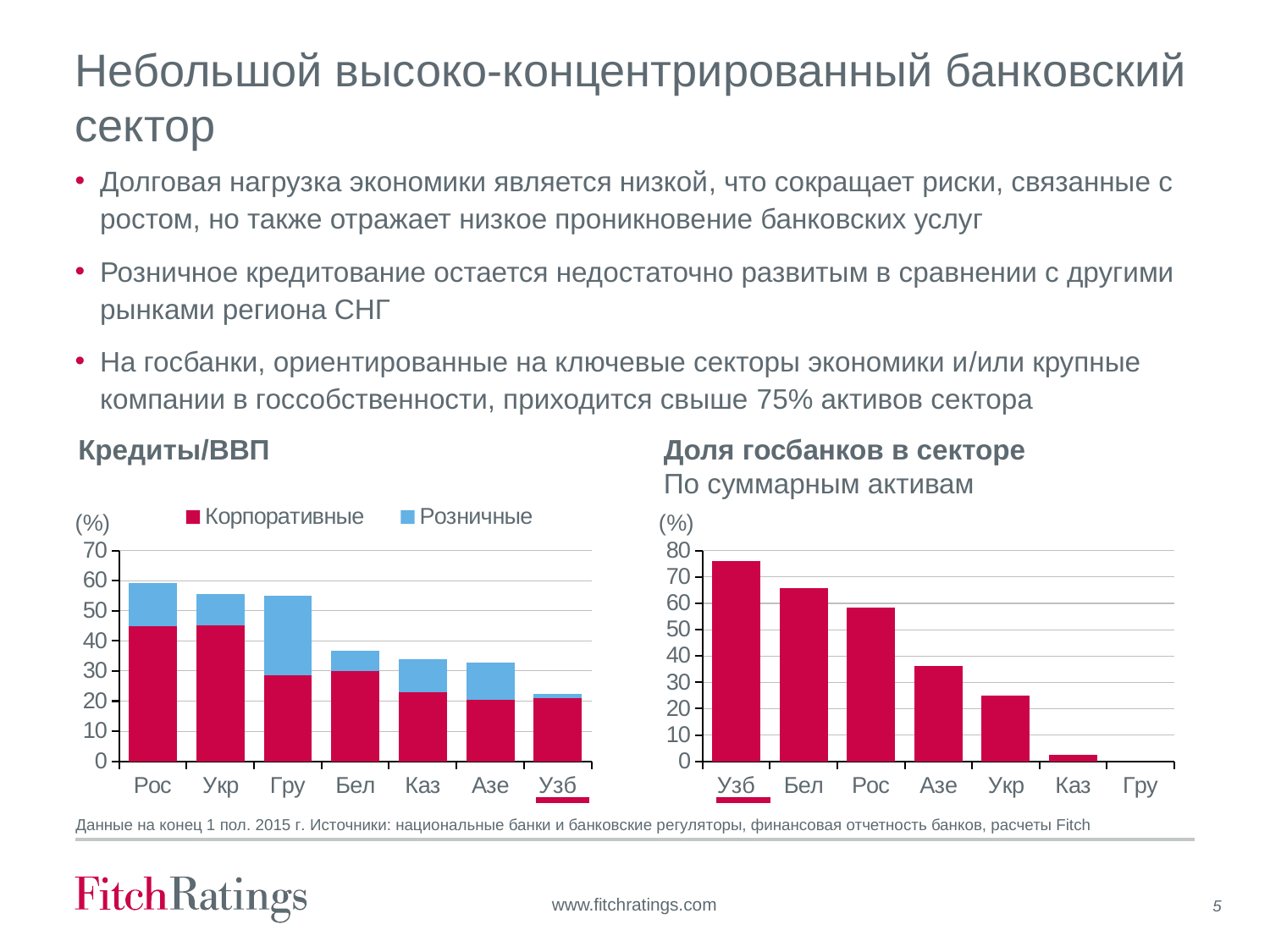
On the chart titled "Кредиты/ВВП", which country has the tallest stacked bar? Рос On the chart titled "Доля госбанков в секторе", which country has the highest value? Узб On the chart titled "Доля госбанков в секторе", is the value for Узб greater or less than 70? greater On the chart titled "Кредиты/ВВП", how many series does the legend list? 2 On the chart titled "Кредиты/ВВП", what are the two series named in the legend? Корпоративные and Розничные On the chart titled "Кредиты/ВВП", is the total stacked value for Узб greater or less than 30? less On the chart titled "Доля госбанков в секторе", how many countries are plotted? 7 On the chart titled "Доля госбанков в секторе", which country has the lowest value? Гру On the chart titled "Доля госбанков в секторе", do the values rise or fall from left to right along the x axis? fall On the chart titled "Доля госбанков в секторе", what kind of chart is shown? bar chart On the chart titled "Доля госбанков в секторе", which is larger, the value for Рос or the value for Азе? Рос On the chart titled "Доля госбанков в секторе", is the value for Укр greater or less than 30? less